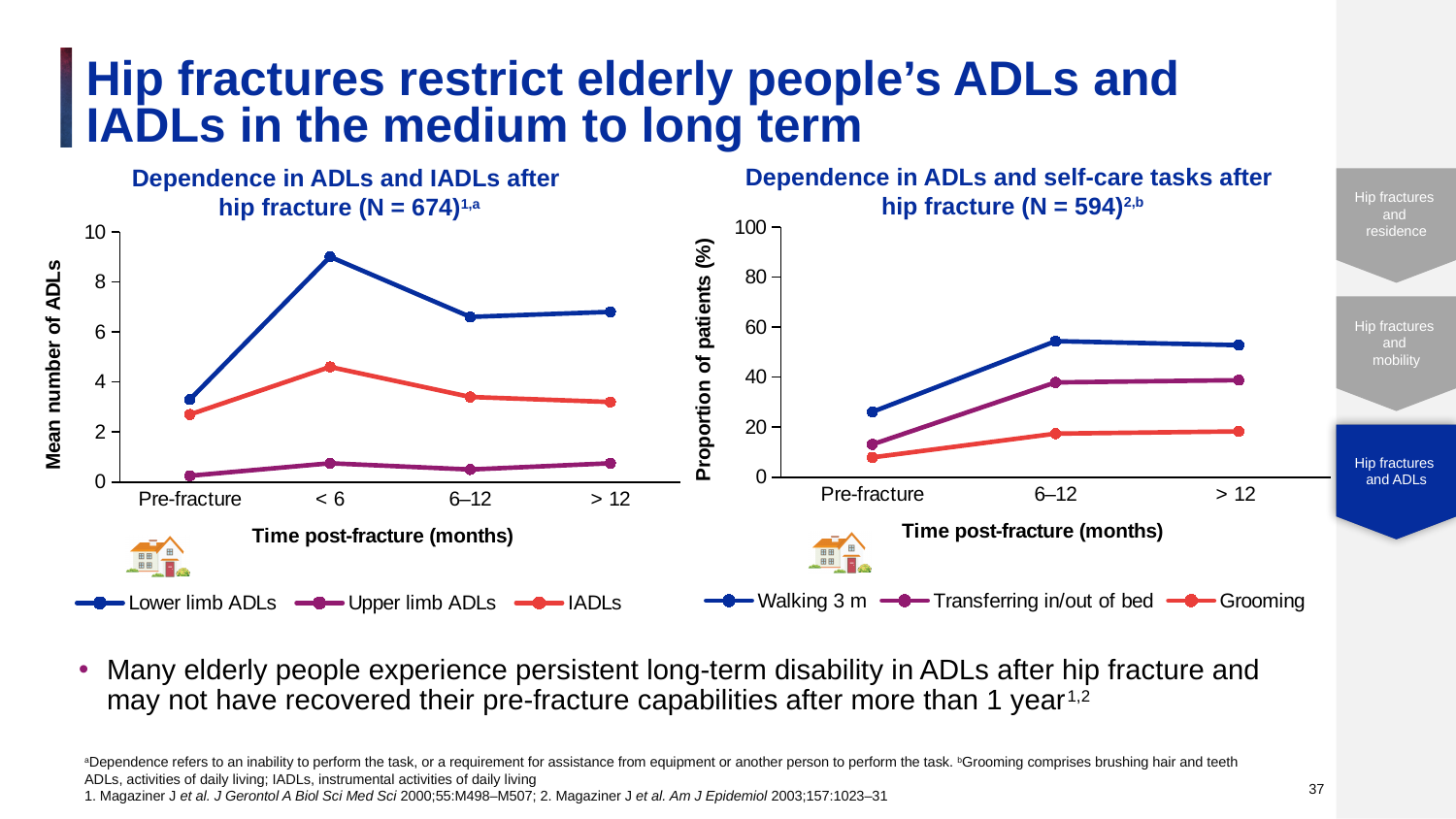
In the right chart, 'Dependence in ADLs and self-care tasks after hip fracture', is the Walking 3 m value at 6–12 months greater or less than 40? greater In the left chart, 'Dependence in ADLs and IADLs after hip fracture', which is larger at 6–12 months: Lower limb ADLs or IADLs? Lower limb ADLs In the right chart, 'Dependence in ADLs and self-care tasks after hip fracture', what is the label of the y axis? Proportion of patients (%) In the left chart, 'Dependence in ADLs and IADLs after hip fracture', at which time point is the Lower limb ADLs value highest? < 6 In the right chart, 'Dependence in ADLs and self-care tasks after hip fracture (N = 594)', how many series does the legend list? 3 What kind of chart is the left chart, 'Dependence in ADLs and IADLs after hip fracture (N = 674)'? Line chart In the left chart, 'Dependence in ADLs and IADLs after hip fracture', how many time points are shown on the x axis? 4 In the left chart, 'Dependence in ADLs and IADLs after hip fracture', how many series does the legend list? 3 In the right chart, 'Dependence in ADLs and self-care tasks after hip fracture', how many time points are shown on the x axis? 3 In the left chart, 'Dependence in ADLs and IADLs after hip fracture', is the Lower limb ADLs value at < 6 months greater or less than 8? greater In the left chart, 'Dependence in ADLs and IADLs after hip fracture', is the IADLs value at Pre-fracture greater or less than 4? less In the right chart, 'Dependence in ADLs and self-care tasks after hip fracture', which series has the lowest value at > 12 months? Grooming